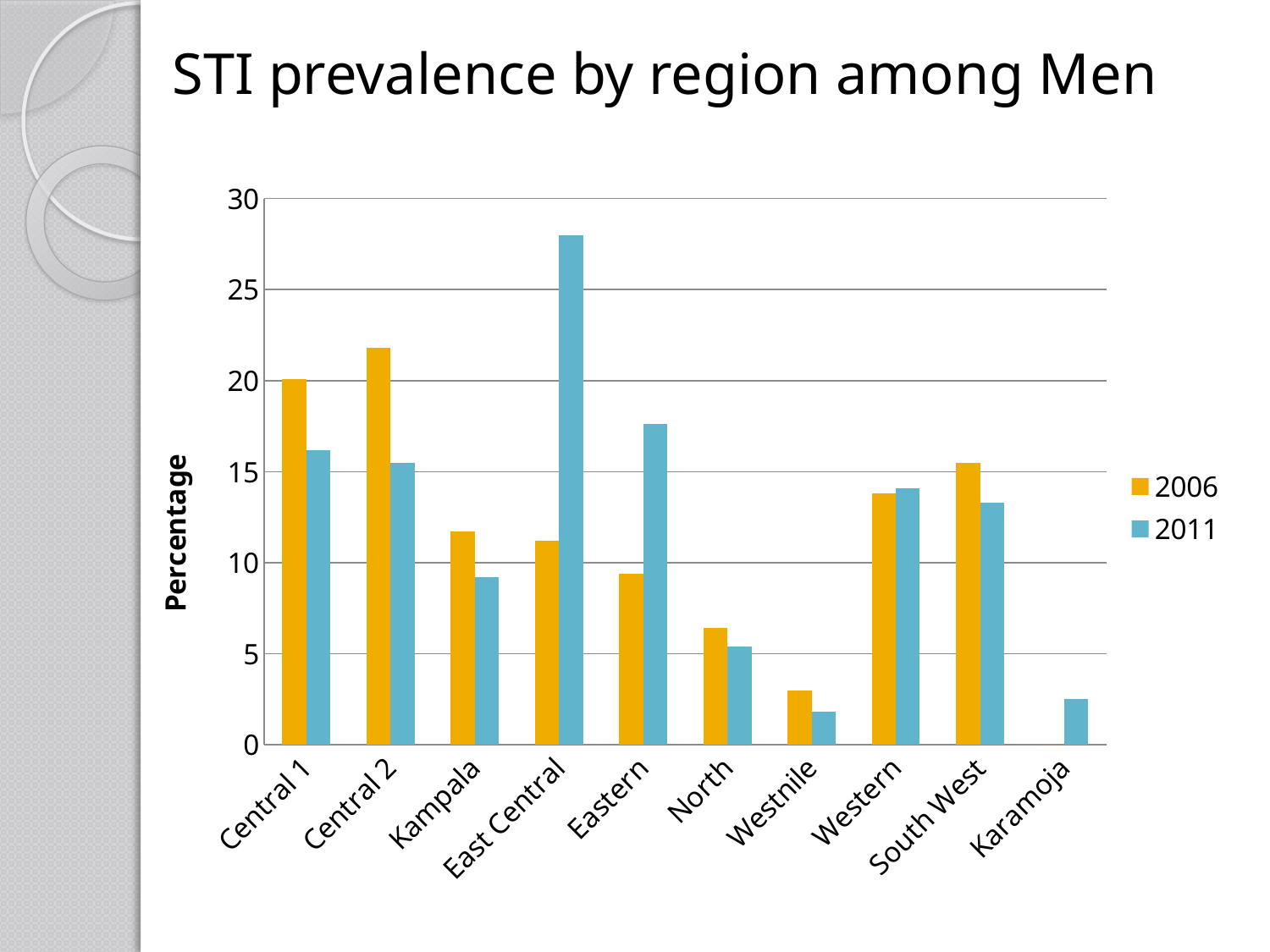
Is the 2006 value for Central 2 greater or less than 20? greater Is the 2006 value for Westnile greater or less than 5? less Which region has the highest 2006 value? Central 2 For Central 1, which is larger: the 2006 value or the 2011 value? 2006 What kind of chart is shown on the slide? bar chart Which region has the highest 2011 value? East Central Is the 2011 value for Kampala greater or less than 10? less What is the label on the y axis of the chart? Percentage How many regions are shown on the x axis of the chart? 10 For Eastern, which is larger: the 2006 value or the 2011 value? 2011 How many series does the legend list? 2